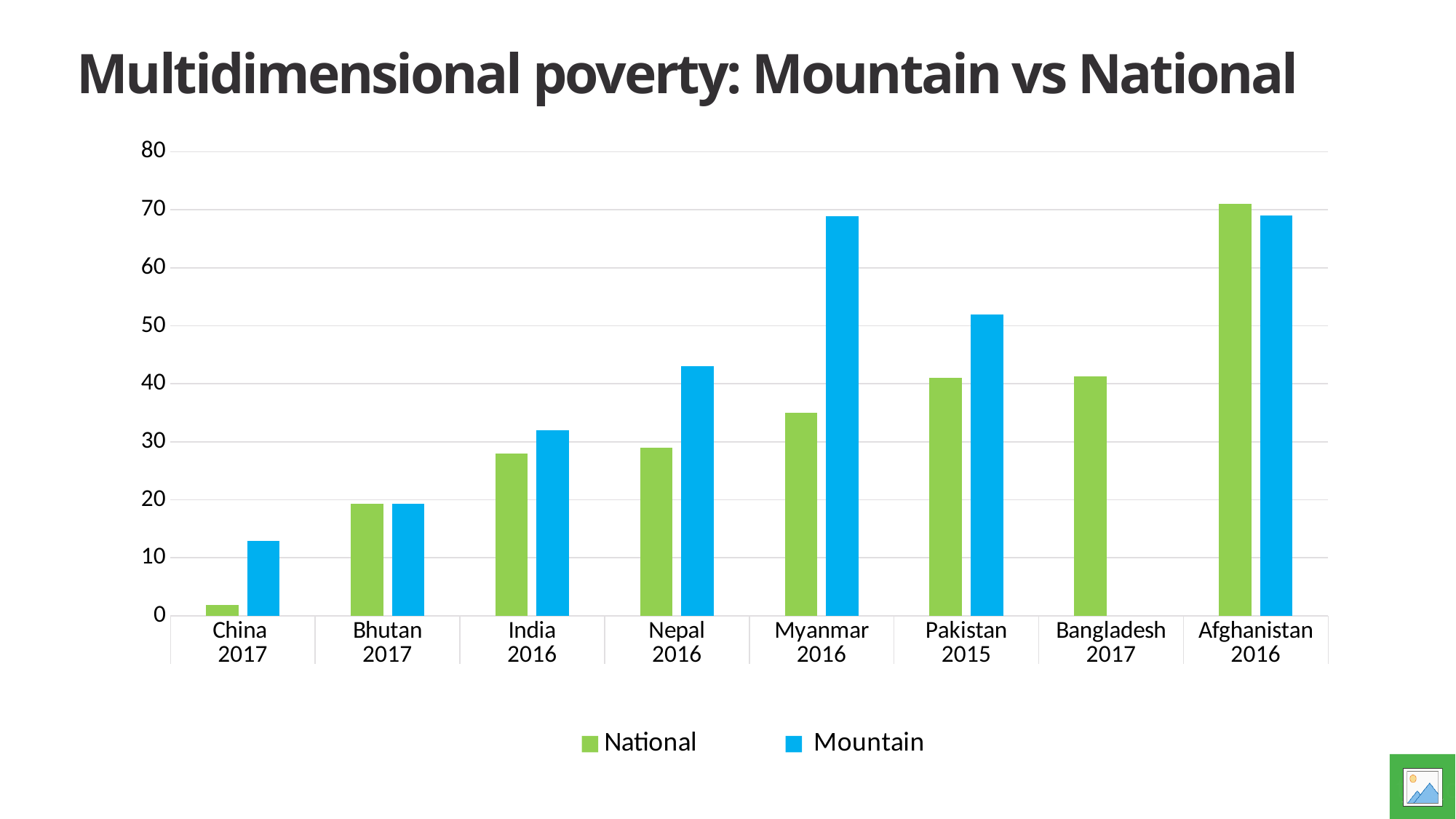
Which country has no Mountain bar shown? Bangladesh 2017 Which country has the lowest National value? China 2017 Is the National value for China 2017 greater or less than 10? less Which country has the highest National value? Afghanistan 2016 Which country has the lowest Mountain value? China 2017 What kind of chart is shown on the slide? Bar chart What colour are the National bars? Green Is the Mountain value for Nepal 2016 greater or less than 40? greater For Myanmar 2016, which is larger: the National value or the Mountain value? Mountain How many series does the legend list? 2 How many countries are shown on the x axis? 8 Is the Mountain value for Myanmar 2016 greater or less than 60? greater